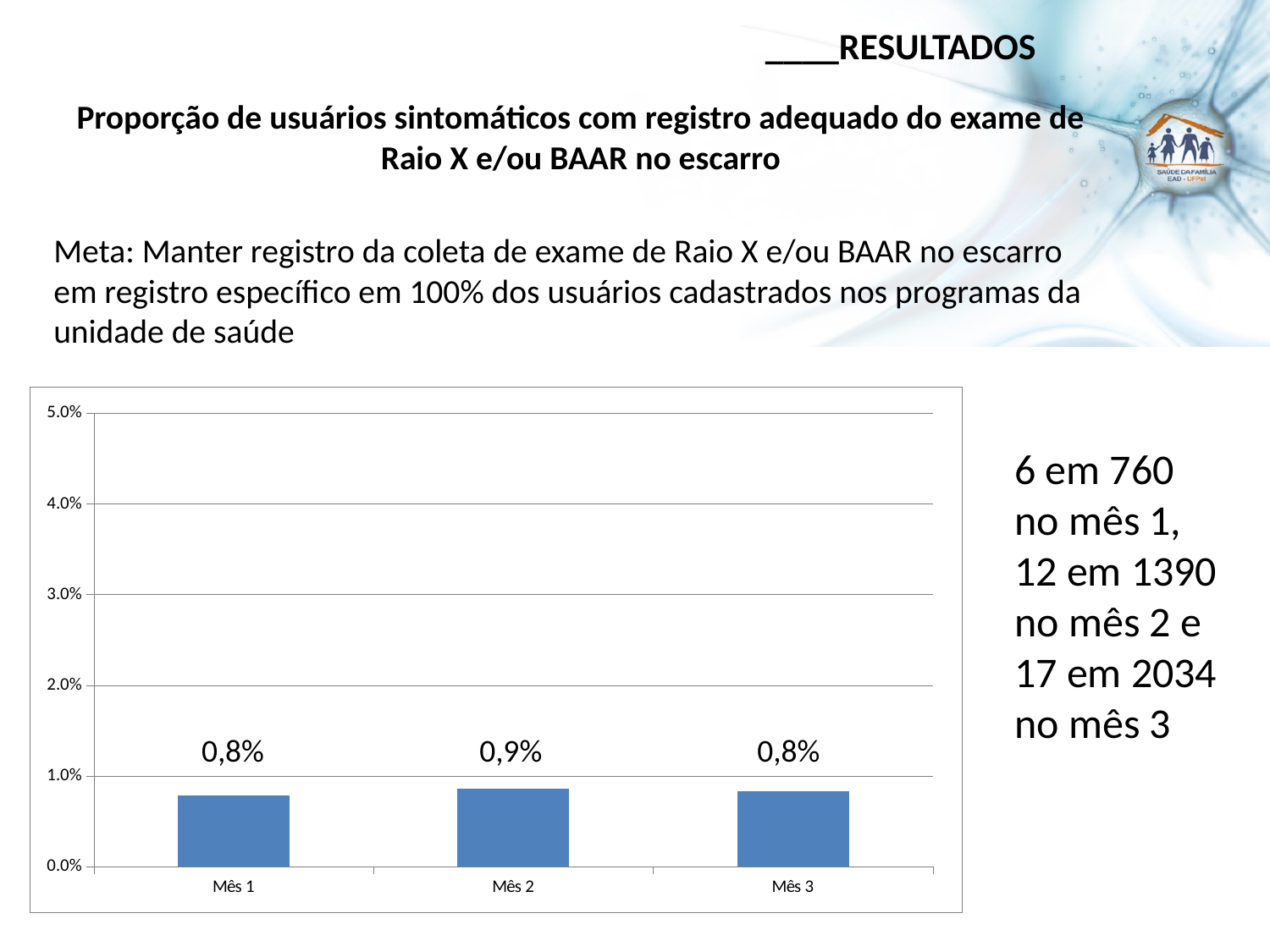
Which is larger, the value for Mês 2 or the value for Mês 3? Mês 2 What is the value shown for Mês 3? 0,8% Is the value for Mês 2 greater or less than 1.0%? less What is the highest value marked on the vertical axis of the chart? 5.0% What is the value shown for Mês 1? 0,8% What is the difference between the values for Mês 2 and Mês 1? 0,1% What kind of chart is shown on the slide? Bar chart How many months (categories) are shown on the x axis of the chart? 3 What is the value shown for Mês 2? 0,9% Which month has the highest value in the chart? Mês 2 What colour are the bars in the chart? Blue Is the value for Mês 1 greater or less than 2.0%? less